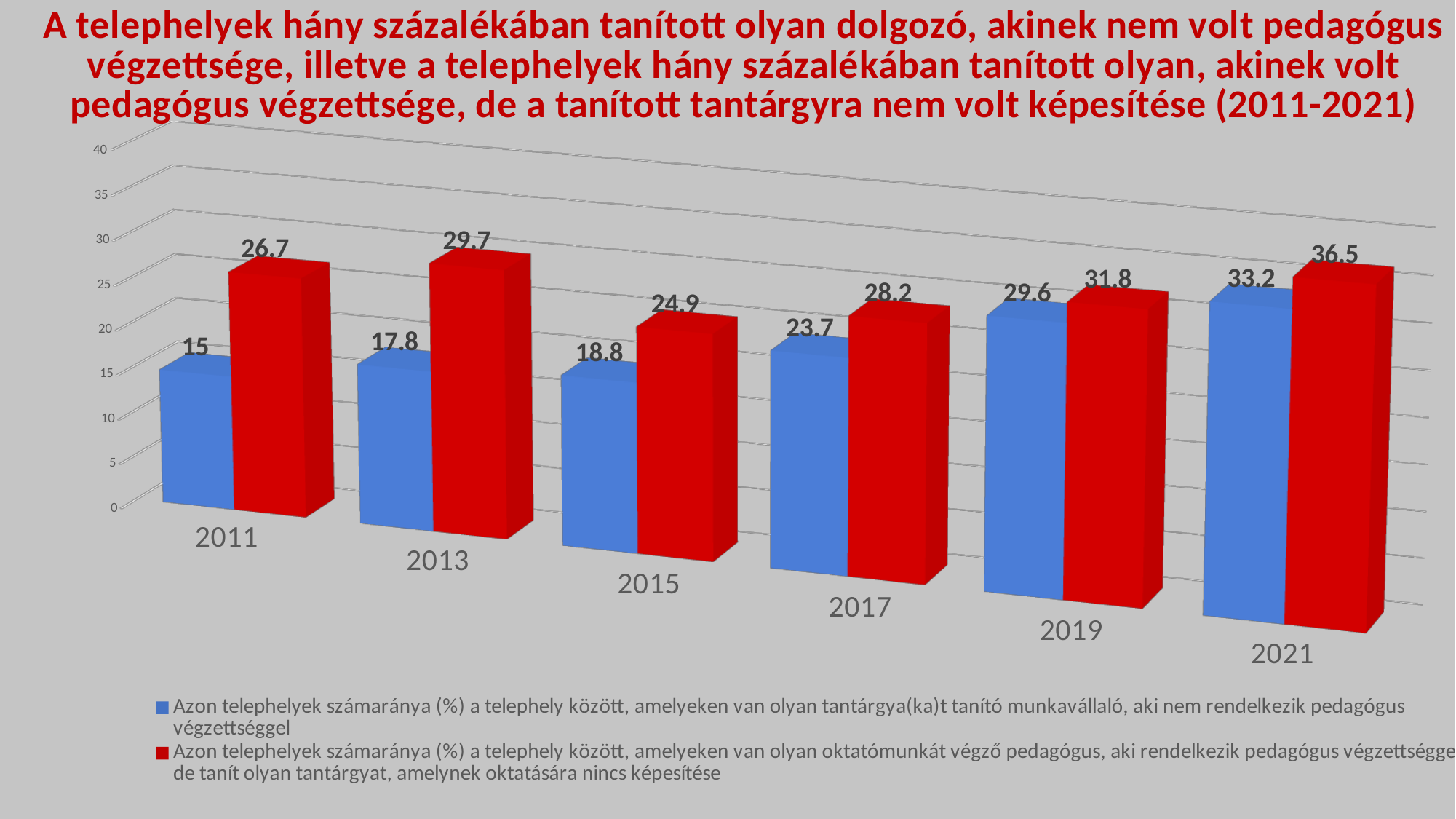
What is the value of the blue series (employees without pedagogical qualification) for 2011? 15 Which is larger in 2015, the blue series or the red series? the red series How many series does the legend list? 2 In which year is the blue series lowest? 2011 What is the value of the blue series for 2019? 29.6 What is the difference between the red and blue values in 2013? 11.9 What is the value of the red series (qualified teachers teaching a subject without certification) for 2021? 36.5 In which year is the red series highest? 2021 What colour represents the series for employees without pedagogical qualification? blue How many years are shown on the x axis? 6 What kind of chart is shown on the slide? bar chart Does the blue series rise or fall from 2011 to 2021? rise